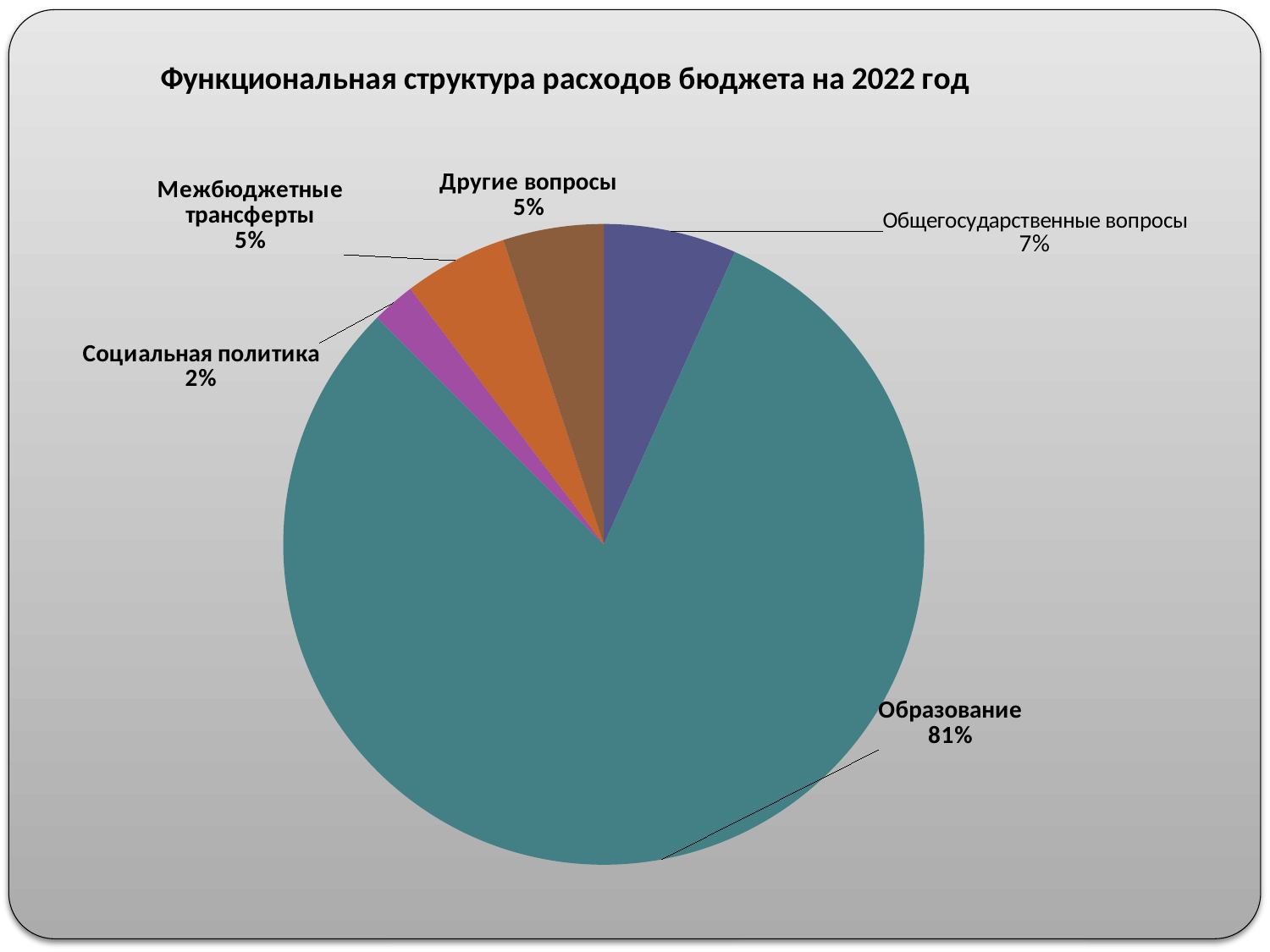
What share of the pie does Образование take? 81% What is the title of the chart? Функциональная структура расходов бюджета на 2022 год What kind of chart is shown on the slide? pie chart Which category has the largest share of the pie? Образование What is the value for Другие вопросы? 5% Which category has the smallest share of the pie? Социальная политика How many slices does the pie chart have? 5 What is the value for Общегосударственные вопросы? 7% What is the value for Межбюджетные трансферты? 5% What is the difference between the shares of Образование and Общегосударственные вопросы? 74% Which is larger, the share of Общегосударственные вопросы or the share of Социальная политика? Общегосударственные вопросы What is the value for Социальная политика? 2%